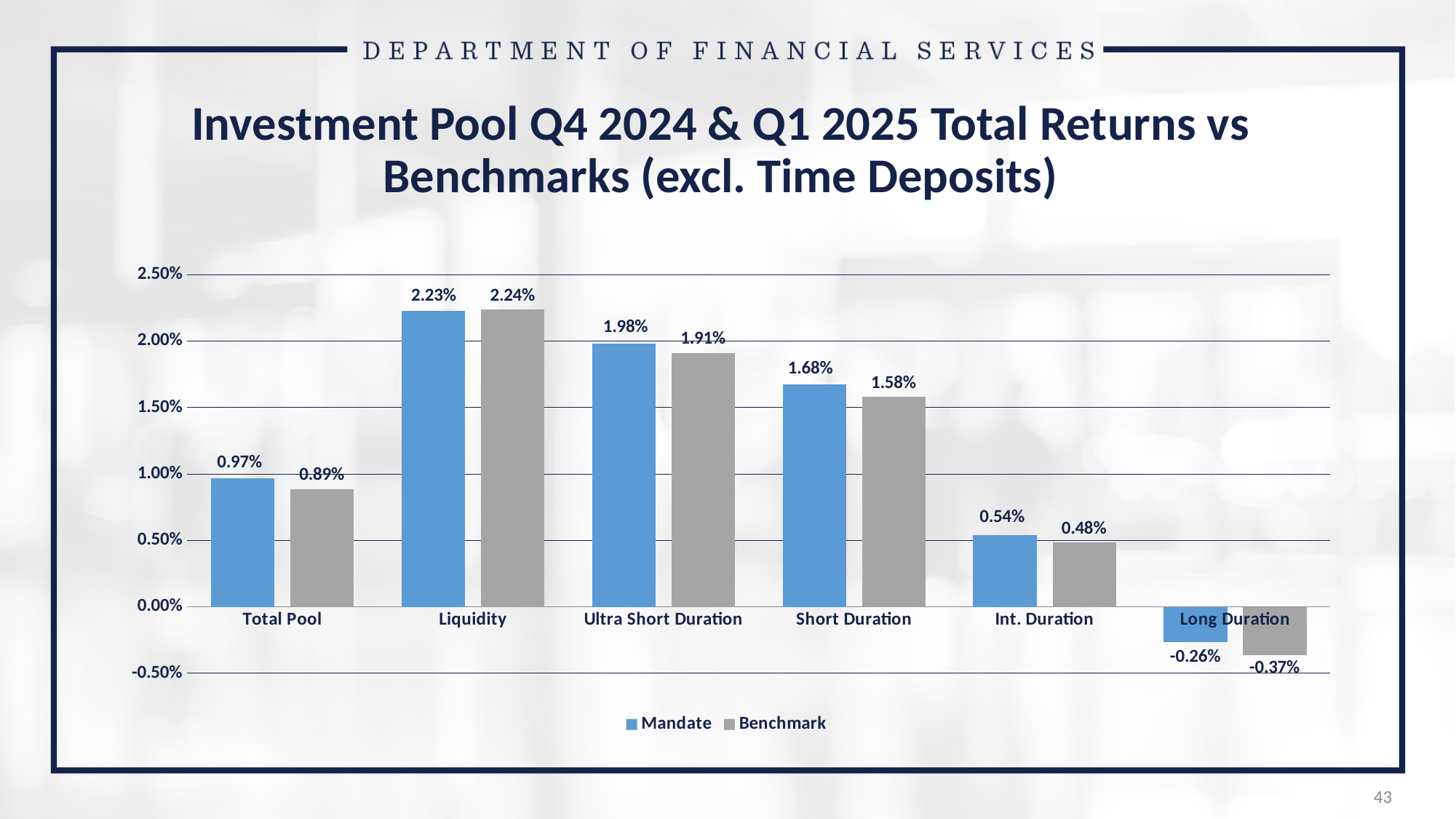
What kind of chart is shown on the slide? Bar chart How many series does the legend list? 2 What is the Mandate value for Long Duration? -0.26% Which category has the lowest Benchmark value? Long Duration Which is larger for Int. Duration, the Mandate value or the Benchmark value? Mandate What is the difference between the Mandate and Benchmark values for Ultra Short Duration? 0.07% How many categories are shown on the x axis? 6 What is the Mandate value for Liquidity? 2.23% What is the Benchmark value for Total Pool? 0.89% What is the Benchmark value for Short Duration? 1.58% Which category has the highest Mandate value? Liquidity What colour are the Benchmark bars? Grey